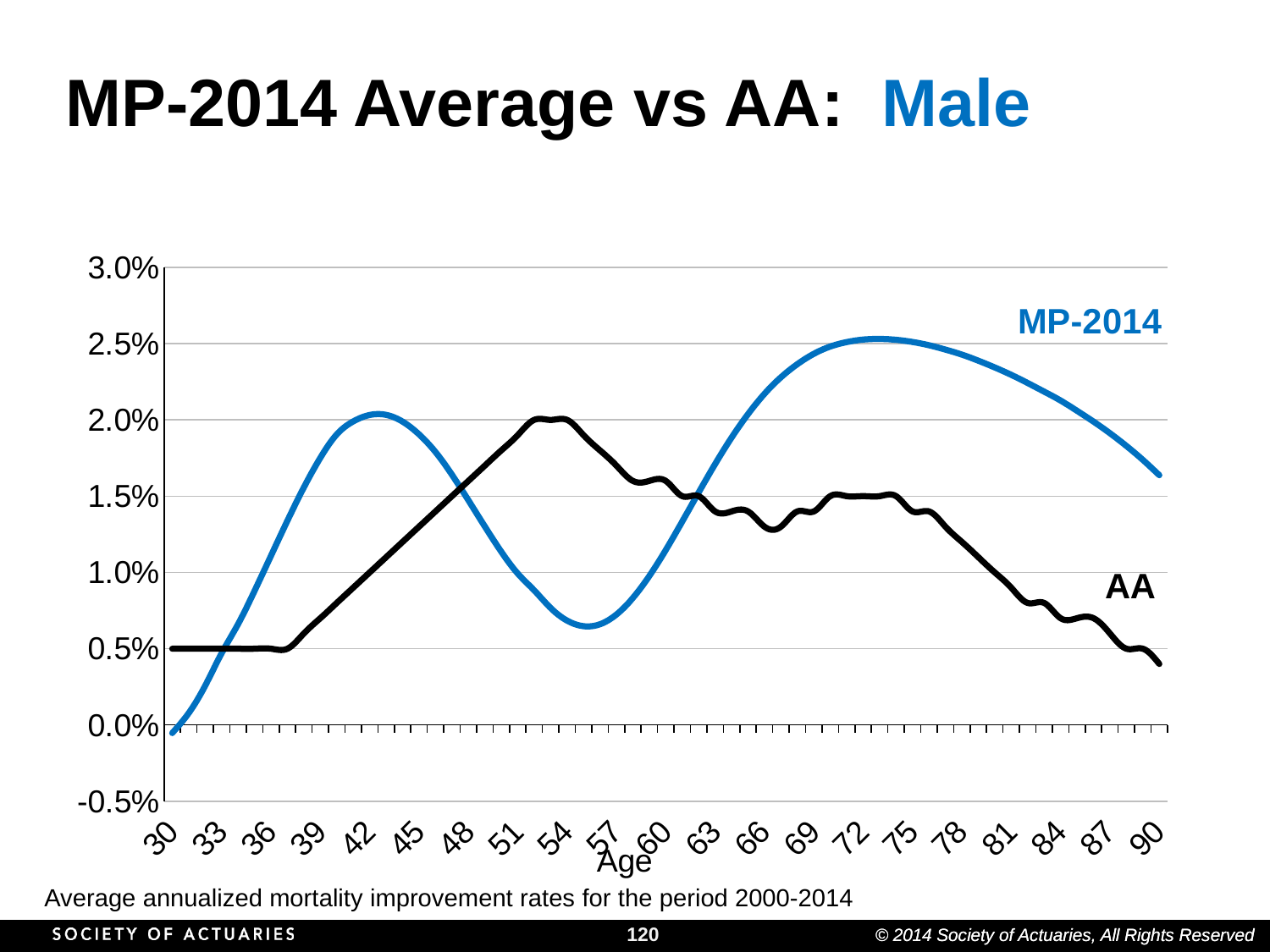
At age 54, which series has the higher value, MP-2014 or AA? AA Is the MP-2014 value at age 72 greater or less than 2.0%? greater Is the AA value at age 90 greater or less than 1.0%? less How many series are plotted on the chart? 2 At age 42, which series has the higher value, MP-2014 or AA? MP-2014 Which series is drawn in blue? MP-2014 Is the MP-2014 value at age 57 greater or less than 1.0%? less What is the title of the x axis? Age What kind of chart is shown on the slide? line chart Does the AA line rise or fall between age 75 and age 90? fall At age 81, which series has the higher value, MP-2014 or AA? MP-2014